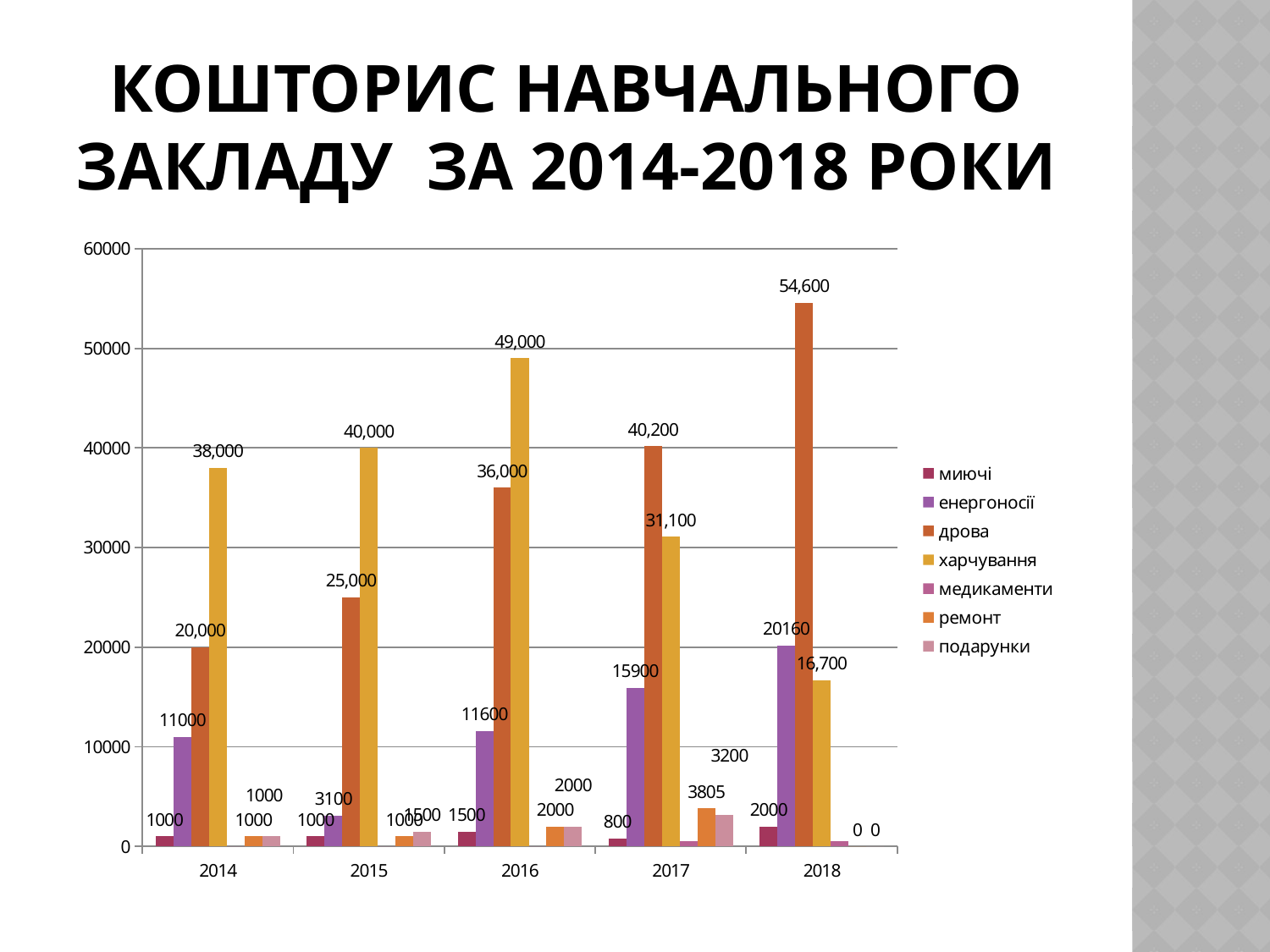
Does the value for дрова rise or fall from 2014 to 2018? rises What is the value for дрова in 2018? 54,600 How many years are shown on the x axis? 5 What is the value for енергоносії in 2017? 15900 How many series does the legend list? 7 What is the difference between the дрова values for 2018 and 2017? 14,400 What is the value for харчування in 2016? 49,000 Is the value for медикаменти in 2017 greater or less than 10000? less In 2017, which is larger: дрова or харчування? дрова In which year is the value for дрова the lowest? 2014 In which year is the value for харчування the highest? 2016 What is the value for ремонт in 2017? 3805